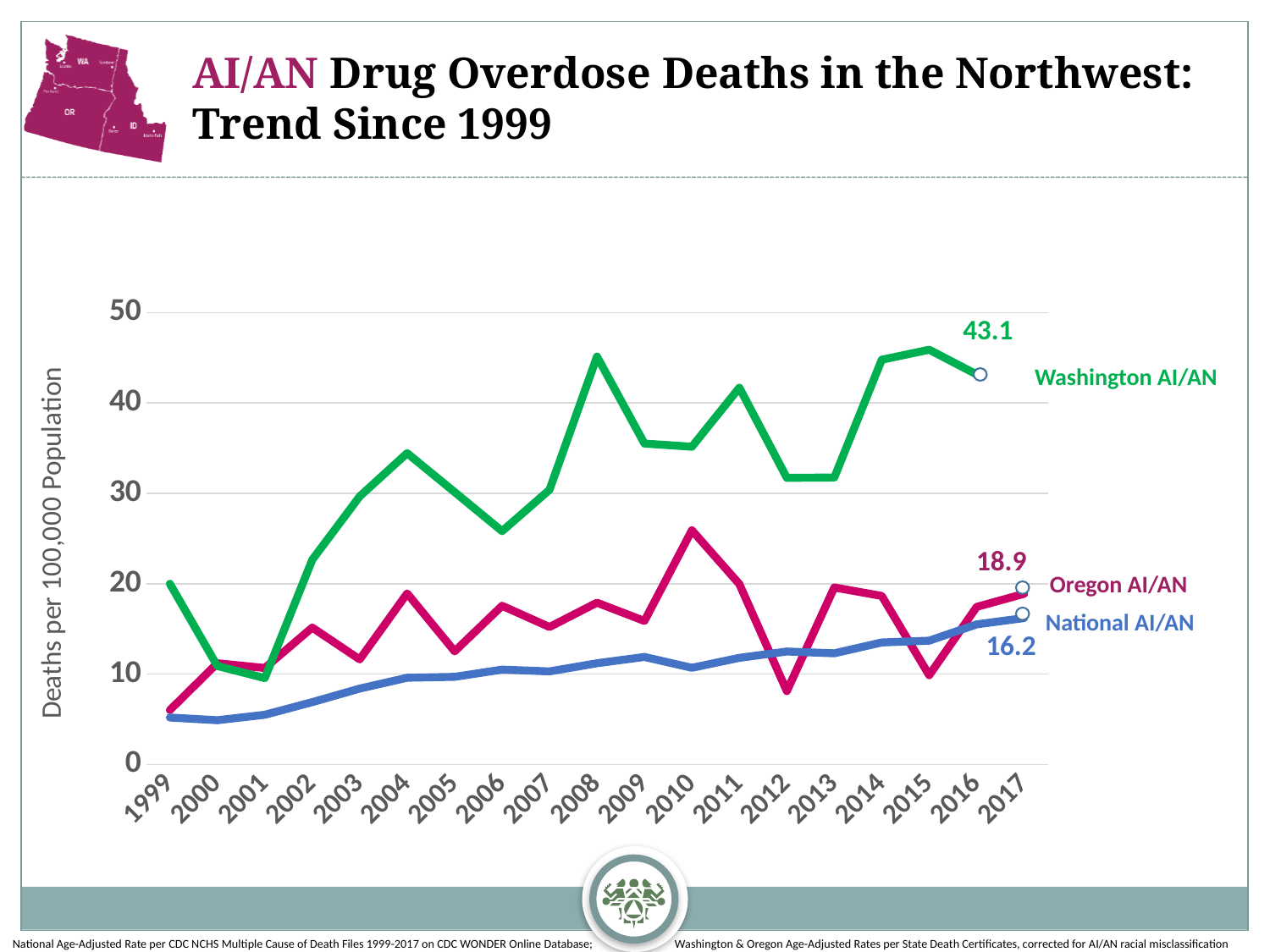
What is the difference between the labelled final values for Oregon AI/AN and National AI/AN? 2.7 What is the title of the vertical axis? Deaths per 100,000 Population Is the value for Washington AI/AN in 2008 greater or less than 40? greater What is the labelled final value for National AI/AN? 16.2 What is the labelled final value for Oregon AI/AN? 18.9 What is the labelled final value for Washington AI/AN? 43.1 What is the difference between the labelled final values for Washington AI/AN and Oregon AI/AN? 24.2 What kind of chart is shown on the slide? line chart Which series has the highest value in 2016? Washington AI/AN Does the National AI/AN line generally rise or fall from 1999 to 2017? rise How many data series are labelled on the chart? 3 Is the value for Oregon AI/AN in 2012 greater or less than 10? less